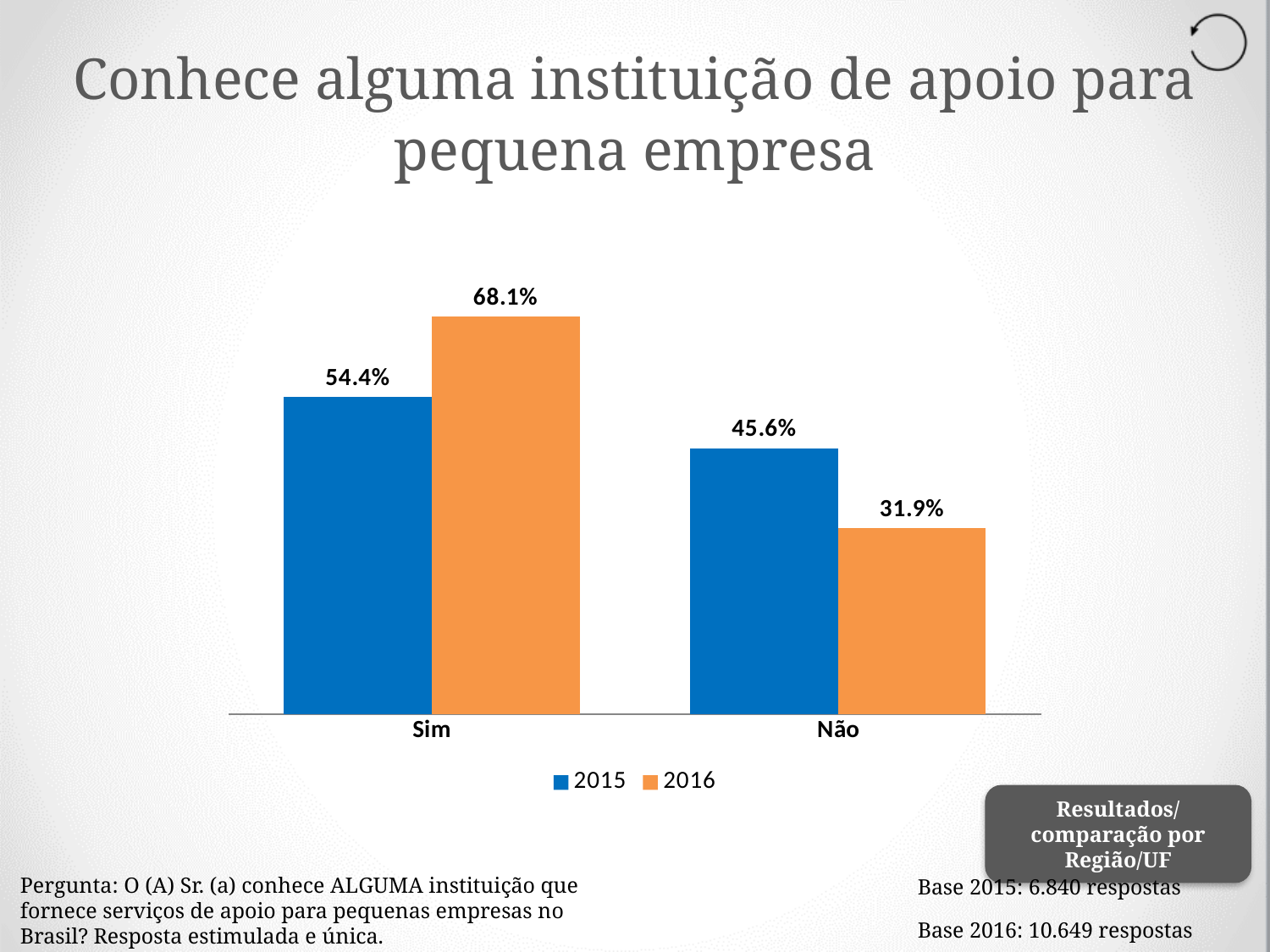
Which is larger for 'Não': the 2015 value or the 2016 value? 2015 Which category has the lowest value in the 2016 series? Não How many series does the legend list? 2 What is the difference between the 2016 and 2015 values for 'Sim'? 13.7% What kind of chart is shown on the slide? Bar chart What is the value for 'Sim' in the 2015 series? 54.4% What is the value for 'Sim' in the 2016 series? 68.1% What is the value for 'Não' in the 2016 series? 31.9% Which category has the highest value in the 2016 series? Sim What is the difference between the 2015 and 2016 values for 'Não'? 13.7% What is the value for 'Não' in the 2015 series? 45.6% How many categories are shown on the x axis? 2